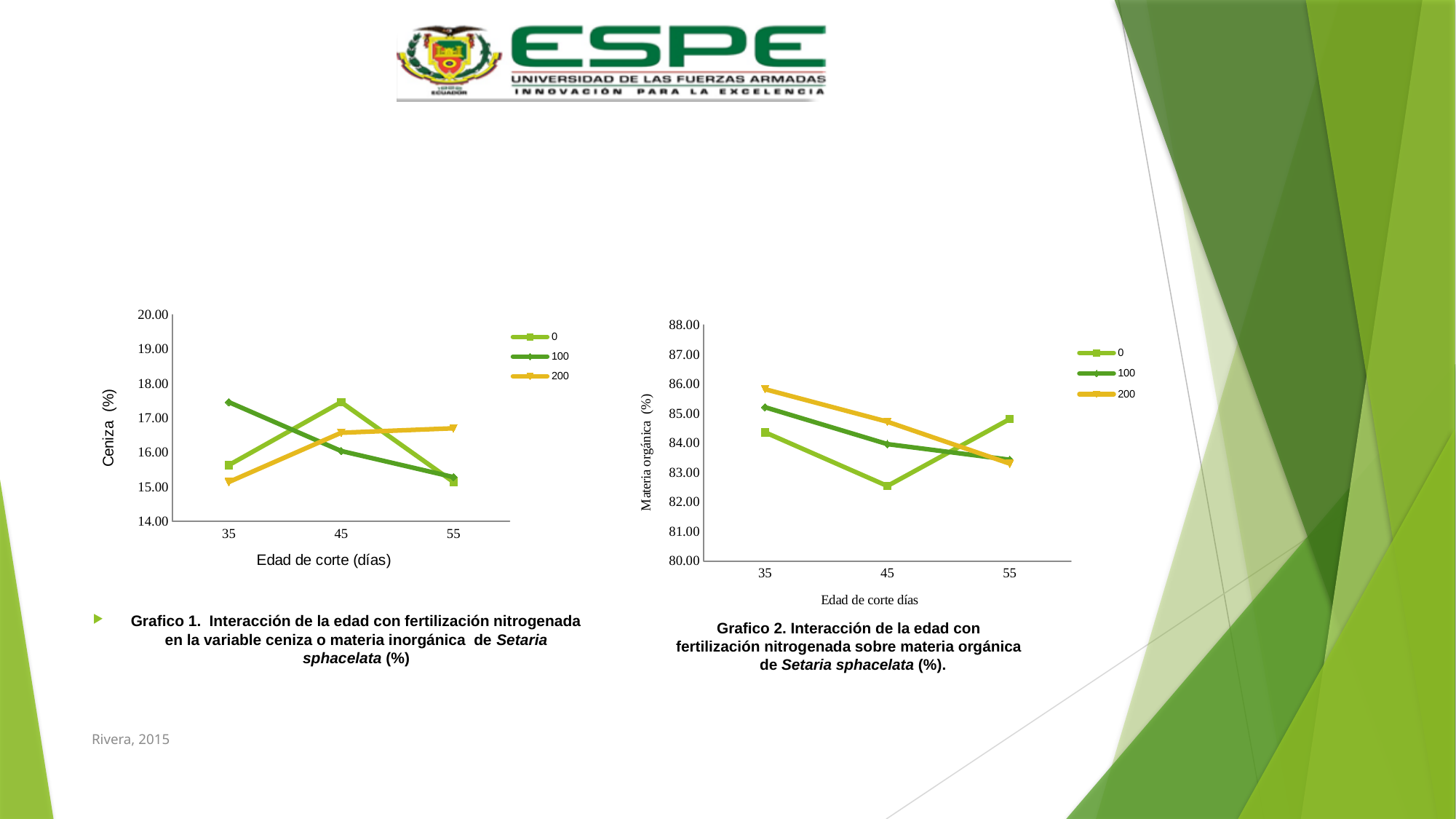
In Grafico 1 (left chart), at which cutting age does series 0 reach its highest value? 45 In Grafico 2 (right chart), does series 200 rise or fall as the cutting age increases from 35 to 55 days? falls In Grafico 2 (right chart), is the value of series 200 at 35 days greater or less than 85.00? greater In Grafico 2 (right chart), at 45 days, which series has the larger value: 0 or 200? 200 In Grafico 1 (left chart), is the value of series 0 at 45 days greater or less than 17.00? greater In Grafico 1 (left chart), does series 100 rise or fall as the cutting age increases from 35 to 55 days? falls In Grafico 1 (left chart), how many series does the legend list? 3 In Grafico 1 (left chart), is the value of series 200 at 35 days greater or less than 16.00? less In Grafico 1 (left chart), what kind of chart is shown? line chart In Grafico 1 (left chart), how many cutting ages (Edad de corte) are plotted on the x axis? 3 In Grafico 2 (right chart), what is the title of the y axis? Materia orgánica (%) In Grafico 2 (right chart), at which cutting age does series 0 reach its lowest value? 45